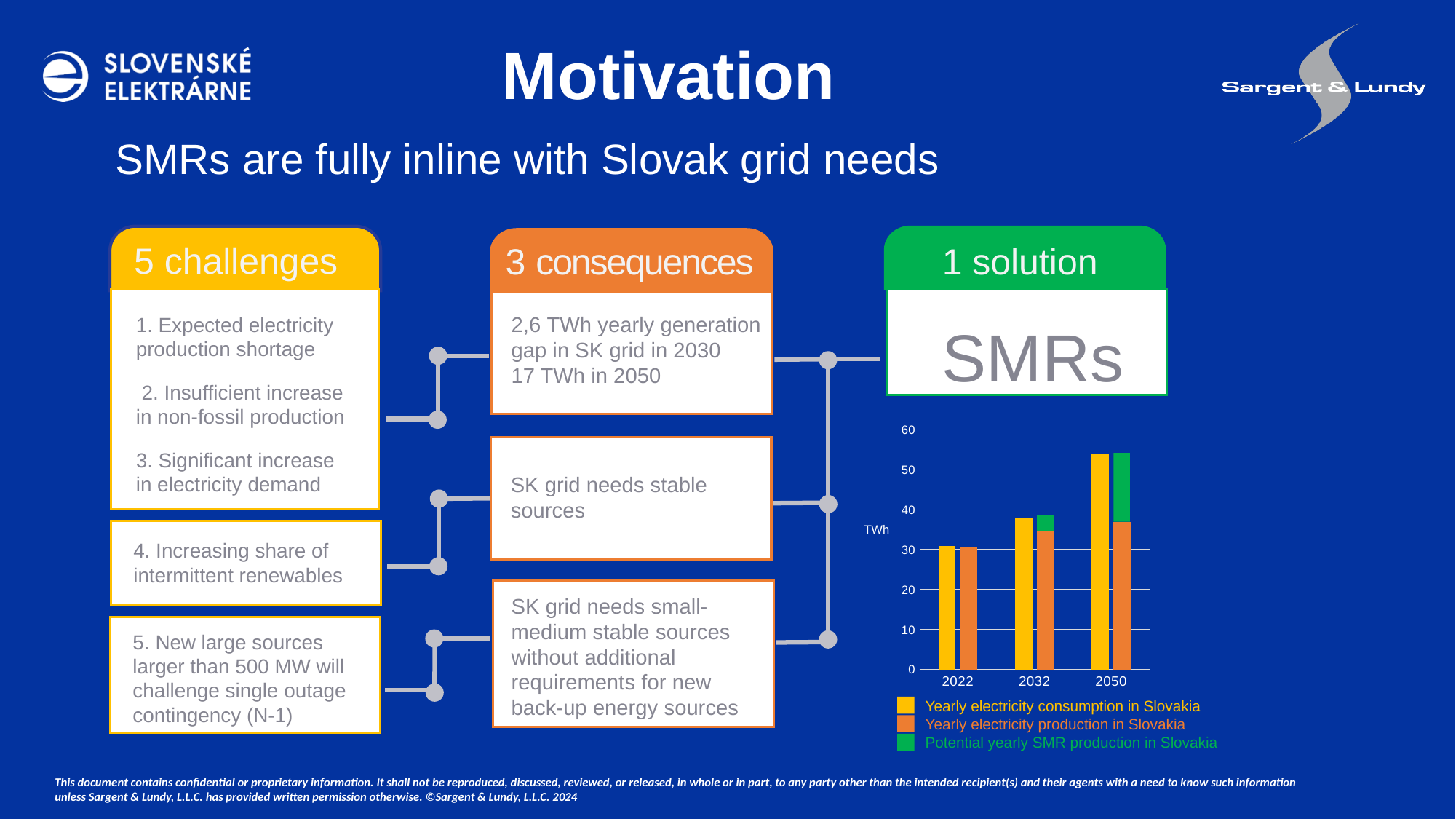
What unit is shown on the y axis of the chart? TWh Is the value for yearly electricity consumption in Slovakia in 2050 greater or less than 50? greater How many years are shown on the x axis of the chart? 3 How many series does the chart legend list? 3 What kind of chart is shown on the slide? bar chart In 2050, which is larger: yearly electricity consumption in Slovakia or yearly electricity production in Slovakia? Yearly electricity consumption in Slovakia In which year is yearly electricity consumption in Slovakia lowest in the chart? 2022 Does yearly electricity consumption in Slovakia rise or fall from 2022 to 2050 in the chart? rises Is the value for yearly electricity consumption in Slovakia in 2032 greater or less than 40? less Which colour represents potential yearly SMR production in Slovakia in the chart? green In which year is yearly electricity consumption in Slovakia highest in the chart? 2050 Is the value for yearly electricity production in Slovakia in 2050 greater or less than 40? less